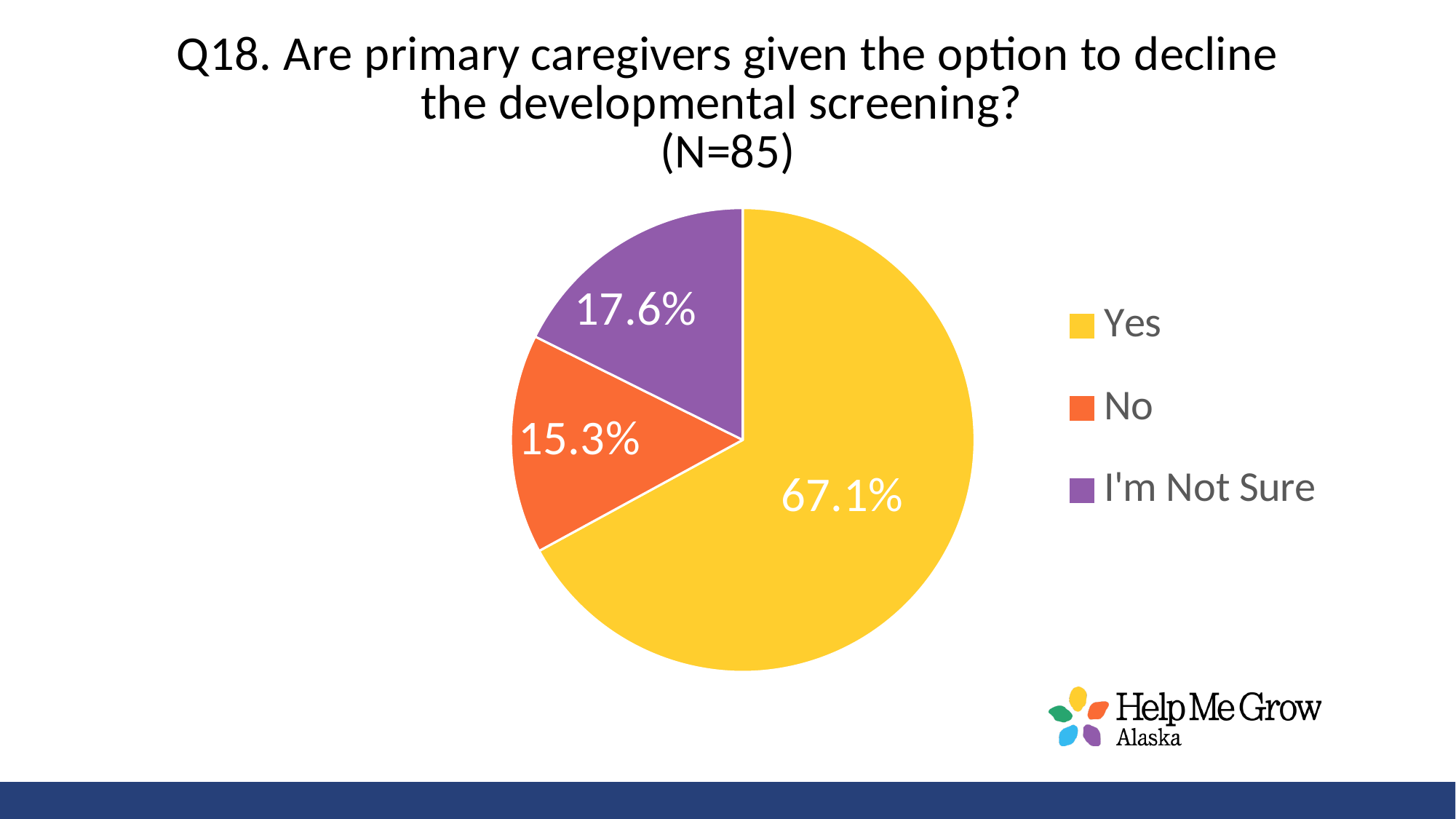
Which response has the largest share of the pie? Yes What is the sample size (N) stated in the chart title? 85 How many slices does the pie chart have? 3 What percentage of respondents answered I'm Not Sure? 17.6% What percentage of respondents answered Yes? 67.1% What is the difference in percentage points between Yes and No? 51.8 What is the difference in percentage points between I'm Not Sure and No? 2.3 Which is larger, the share for No or the share for I'm Not Sure? I'm Not Sure What percentage of respondents answered No? 15.3% Which response has the smallest share of the pie? No What colour is the slice for I'm Not Sure? Purple What kind of chart is shown on the slide? Pie chart